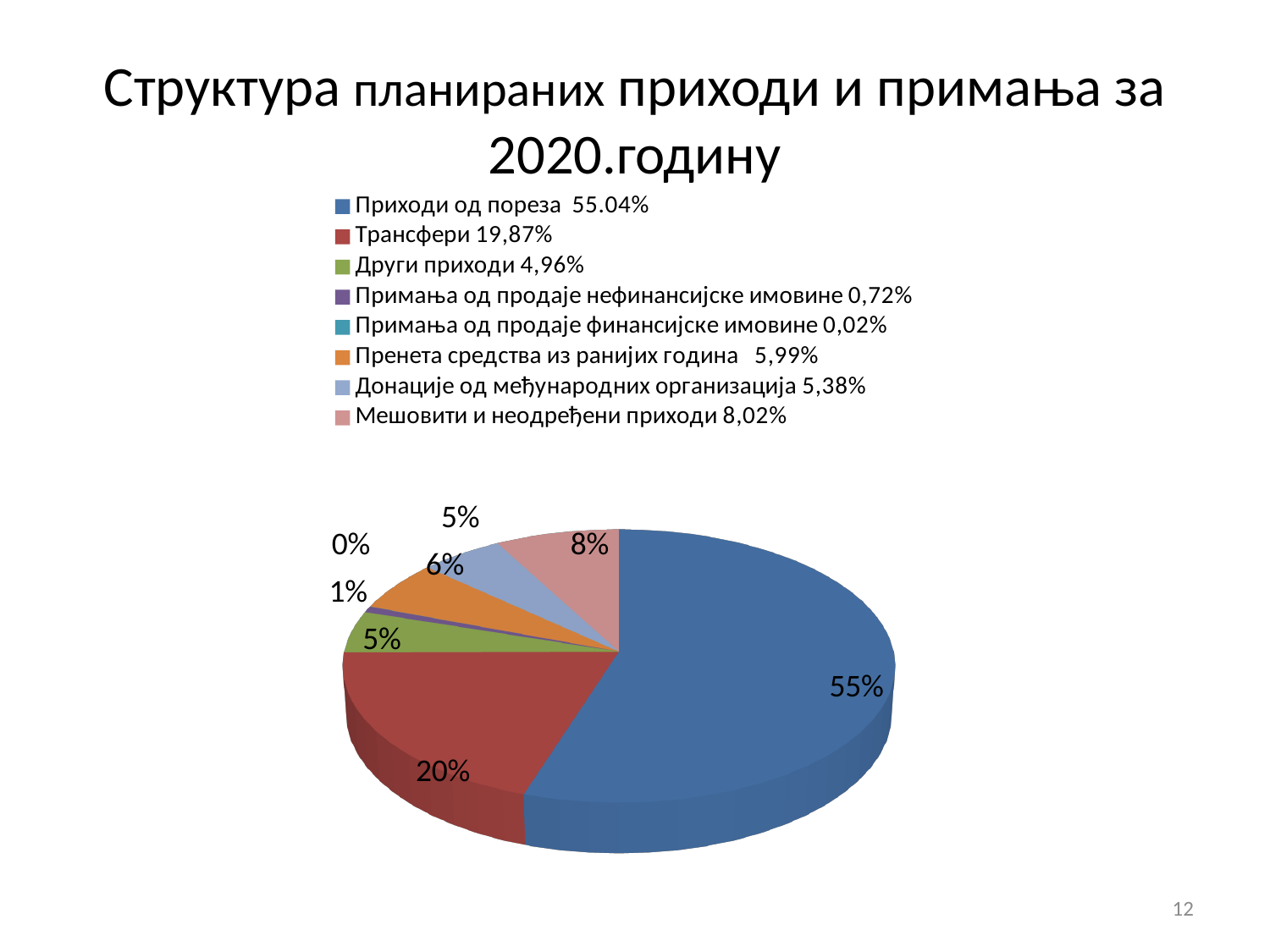
How many categories does the legend of the pie chart list? 8 Which category has the smallest share according to the legend? Примања од продаје финансијске имовине What percentage is shown in the legend for Мешовити и неодређени приходи? 8,02% What percentage is shown in the legend for Трансфери? 19,87% What is the difference between the legend percentages for Трансфери (19,87%) and Мешовити и неодређени приходи (8,02%)? 11,85% What data label is printed on the pie slice for Приходи од пореза? 55% What percentage is shown in the legend for Пренета средства из ранијих година? 5,99% What colour is the slice for Приходи од пореза? blue What kind of chart is shown on the slide? pie chart What is the difference between the legend percentages for Пренета средства из ранијих година (5,99%) and Донације од међународних организација (5,38%)? 0,61% Which category has the largest slice of the pie? Приходи од пореза Which is larger: the share of Трансфери or the share of Други приходи? Трансфери